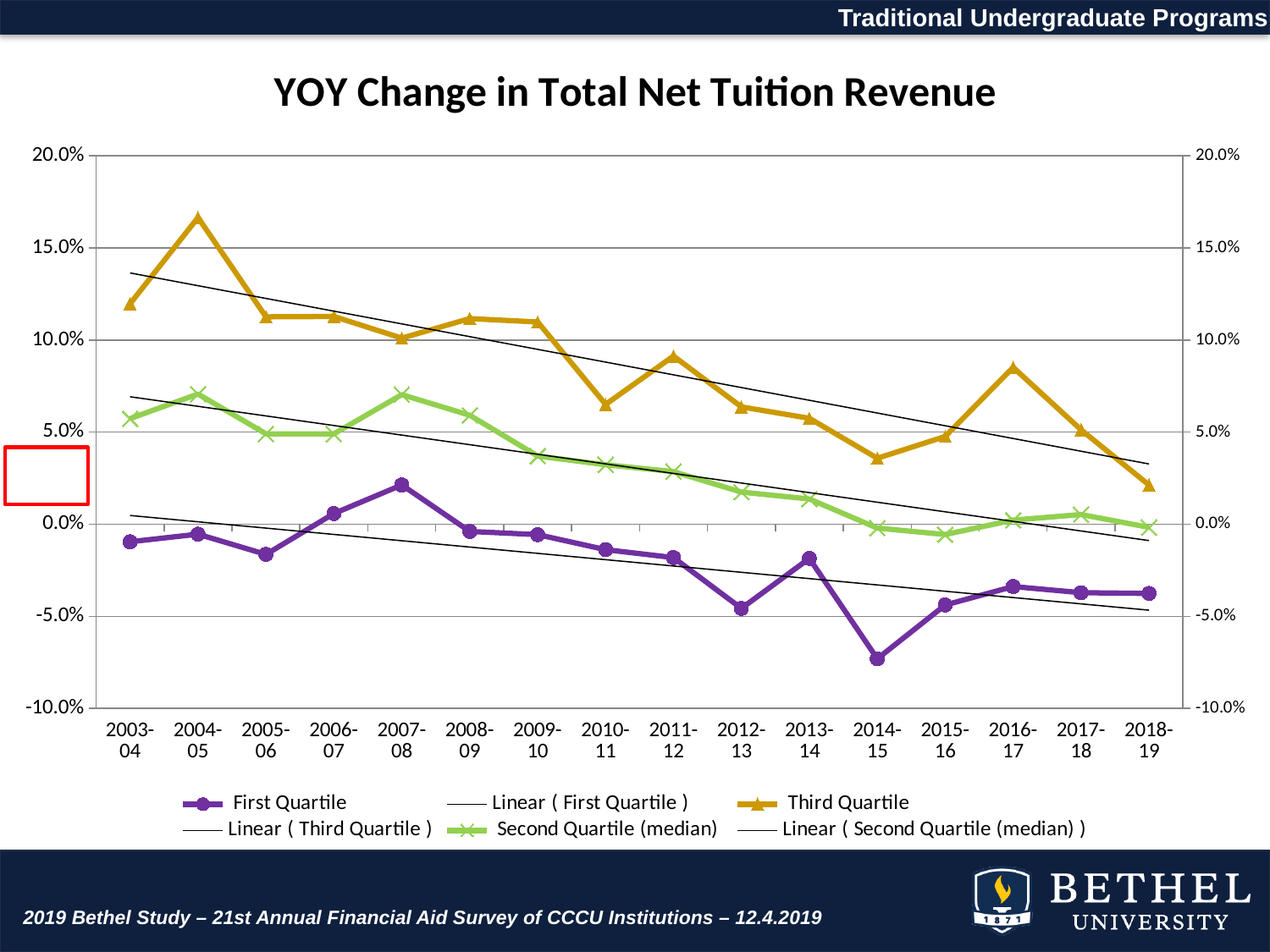
Is the Third Quartile value for 2004-05 greater or less than 15.0%? greater How many academic years are plotted along the x axis? 16 What is the title of the chart? YOY Change in Total Net Tuition Revenue In which year does the First Quartile series reach its lowest value? 2014-15 Is the First Quartile value for 2014-15 greater or less than -5.0%? less How many entries does the legend list? 6 Is the Second Quartile (median) value for 2007-08 greater or less than 5.0%? greater What kind of chart is shown on the slide? Line chart Which is larger for the Third Quartile series: the value for 2015-16 or the value for 2016-17? 2016-17 In which year does the Third Quartile series reach its highest value? 2004-05 In which year does the Third Quartile series reach its lowest value? 2018-19 Do the Third Quartile values generally rise or fall from 2003-04 to 2018-19? Fall